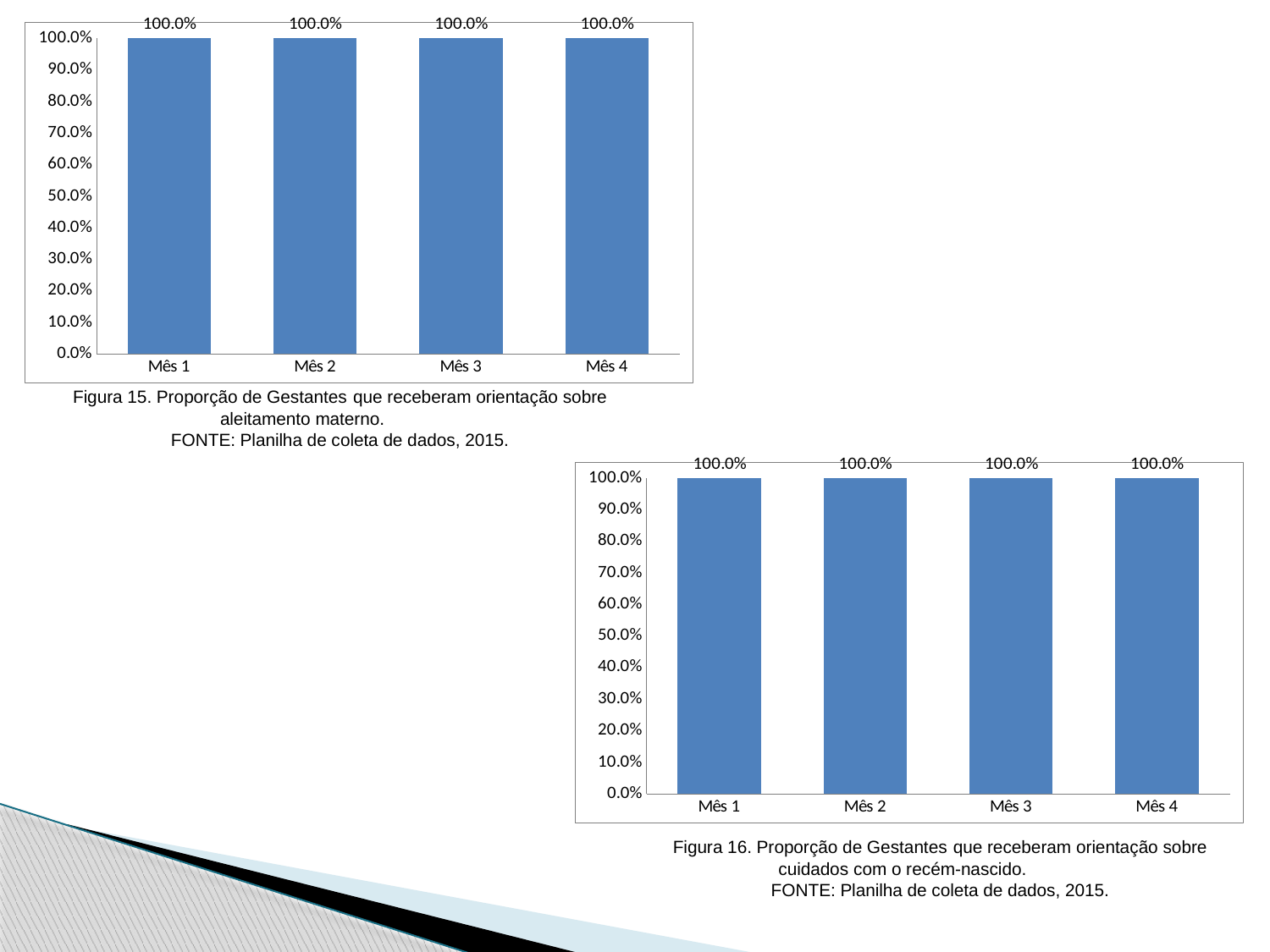
In the bottom-right chart (Figura 16), what is the value for Mês 2? 100.0% How many categories are shown on the x axis of the top-left chart (Figura 15)? 4 In the bottom-right chart (Figura 16), what is the difference between the values for Mês 1 and Mês 4? 0.0% What kind of chart is the bottom-right chart (Figura 16)? Bar chart What kind of chart is the top-left chart (Figura 15)? Bar chart In the top-left chart (Figura 15), do the values rise, fall, or stay the same from Mês 1 to Mês 4? Stay the same In the top-left chart (Figura 15), what is the value for Mês 1? 100.0% How many bars are plotted in the bottom-right chart (Figura 16)? 4 In the bottom-right chart (Figura 16), is the value for Mês 3 greater or less than 50.0%? greater In the top-left chart (Figura 15), what is the value for Mês 3? 100.0% According to its caption, what does the bottom-right chart (Figura 16) show the proportion of pregnant women receiving guidance about? Cuidados com o recém-nascido In the bottom-right chart (Figura 16), what is the value for Mês 4? 100.0%